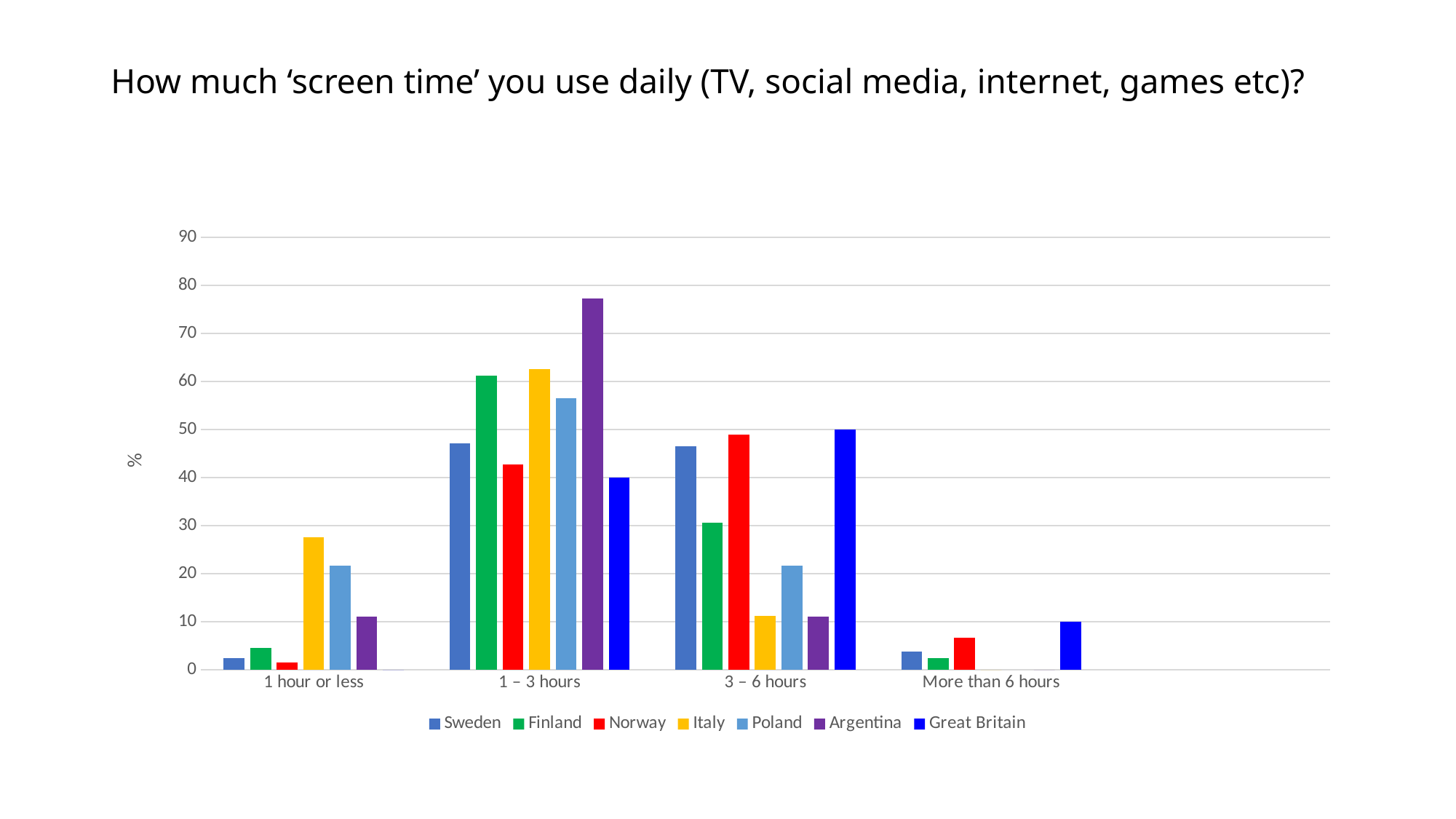
Is the value for Finland in the '3 – 6 hours' category greater or less than 40? less What kind of chart is shown on the slide? bar chart How many screen-time categories are shown on the x axis? 4 Which country has the highest value in the '3 – 6 hours' category? Great Britain What label is shown on the vertical axis? % Is the value for Argentina in the '1 – 3 hours' category greater or less than 70? greater Which country has the highest value in the '1 hour or less' category? Italy In the '1 – 3 hours' category, which is larger: the value for Finland or the value for Sweden? Finland How many series does the legend list? 7 Which country has the highest value in the '1 – 3 hours' category? Argentina In the '3 – 6 hours' category, which is larger: the value for Norway or the value for Italy? Norway